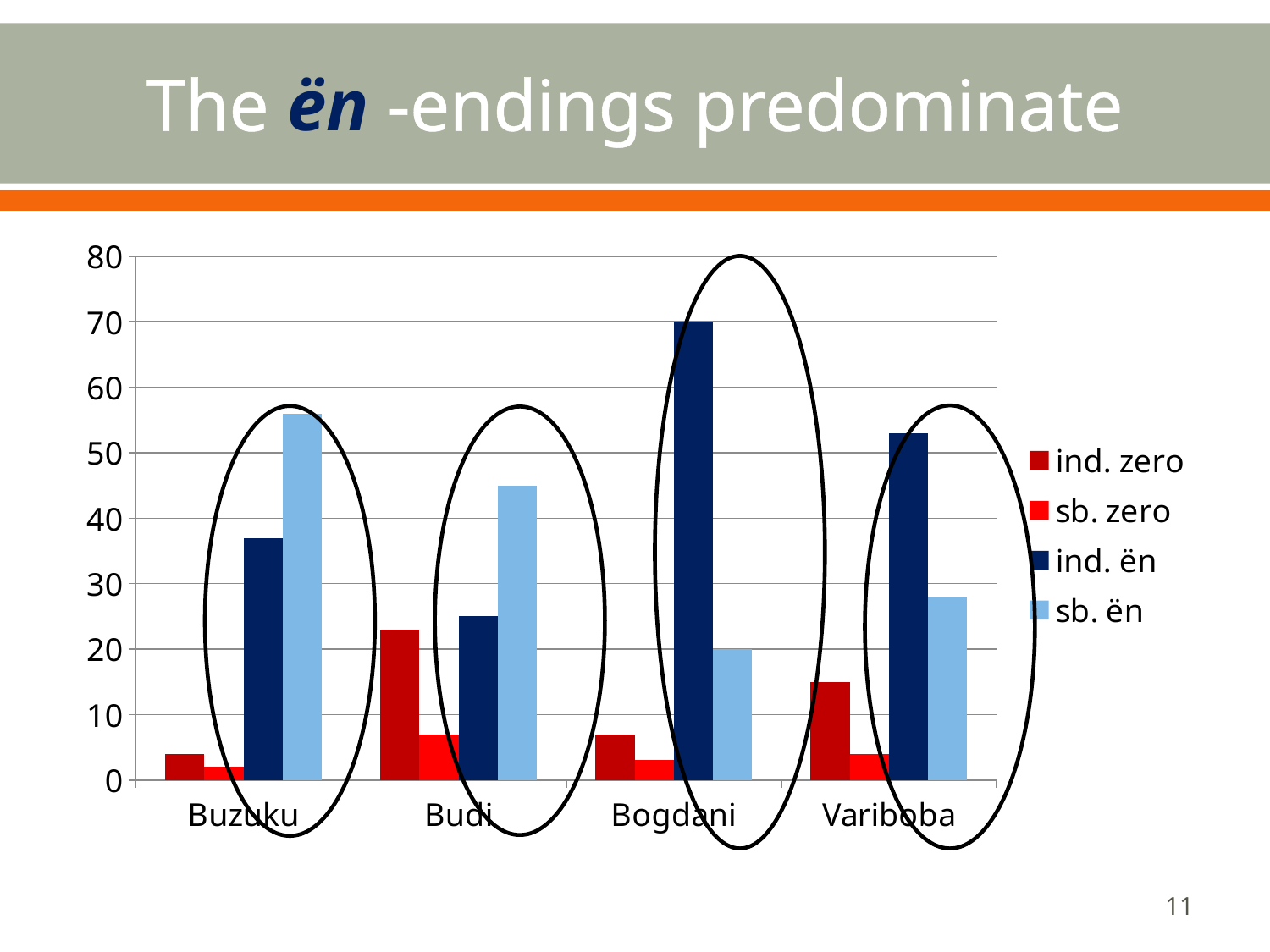
Which category has the highest value for the ind. ën series? Bogdani Which category has the lowest value for the ind. zero series? Buzuku For Variboba, which is larger: ind. ën or sb. ën? ind. ën How many series does the chart's legend list? 4 Which category has the highest value for the sb. ën series? Buzuku For Budi, which is larger: sb. ën or ind. zero? sb. ën How many categories are shown on the x axis of the chart? 4 Is the value of ind. zero for Budi greater or less than 30? less Is the value of sb. ën for Buzuku greater or less than 50? greater What is the value of ind. ën for Bogdani? 70 What kind of chart is shown on the slide? bar chart What is the title of the slide containing the chart? The ën -endings predominate